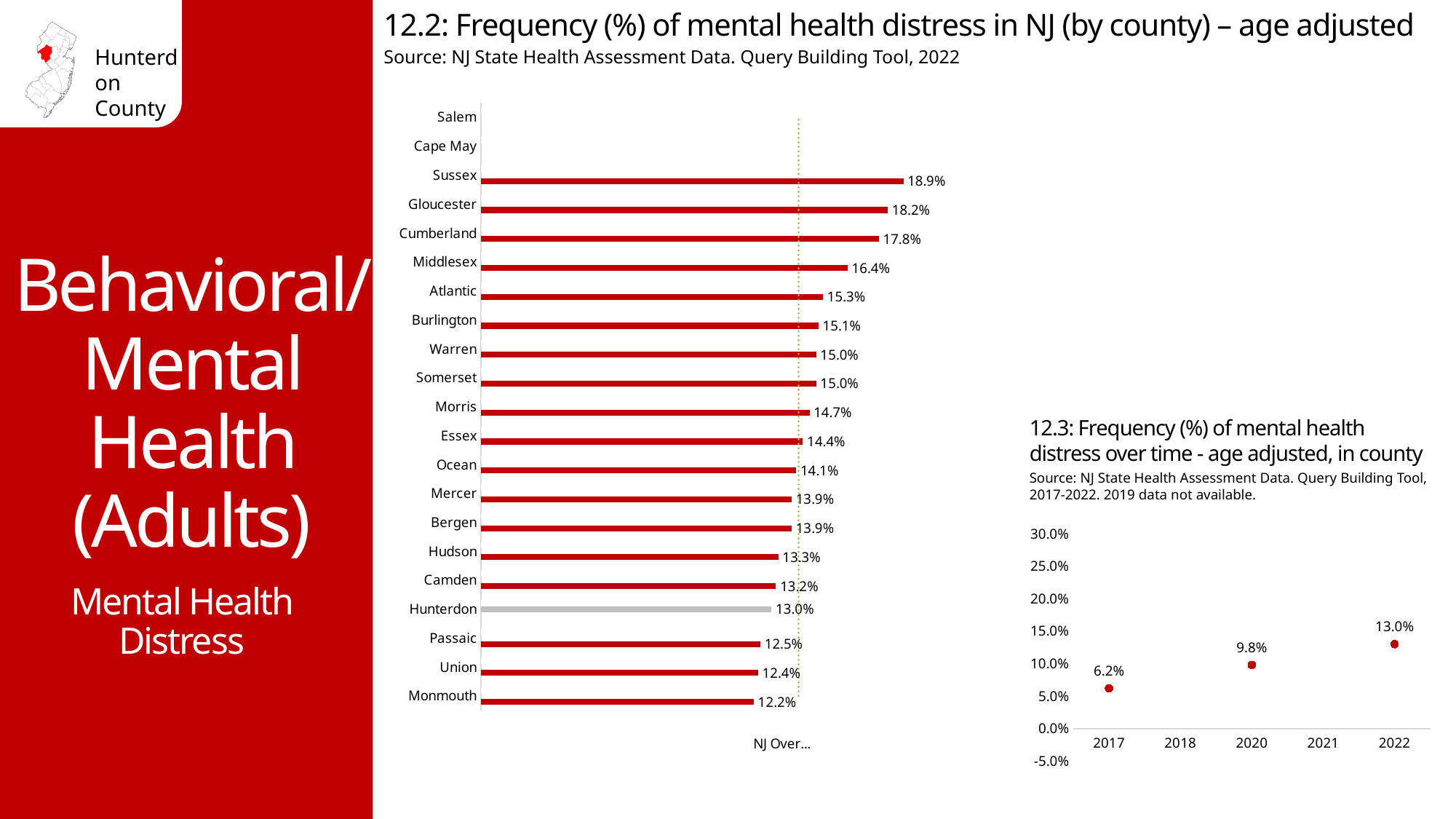
In chart 12.2, which county has a higher value, Middlesex or Atlantic? Middlesex In chart 12.3, what is the difference between the 2022 and 2020 values? 3.2% In chart 12.2, which two counties are listed without a plotted bar or value? Salem and Cape May In chart 12.2, what is the value shown for Hunterdon county? 13.0% In chart 12.2, what is the difference between the values for Gloucester and Hunterdon? 5.2% In chart 12.2, which county with a plotted bar has the lowest frequency of mental health distress? Monmouth In chart 12.2, which county has the highest frequency of mental health distress? Sussex In chart 12.3, do the values rise or fall from 2017 to 2022? Rise In chart 12.2, what is the frequency of mental health distress for Sussex county? 18.9% In chart 12.3, what was the frequency of mental health distress in 2022? 13.0% In chart 12.3, what was the frequency of mental health distress in 2017? 6.2% In chart 12.2, what colour is the Hunterdon bar compared with the other counties' bars? Grey (others are red)